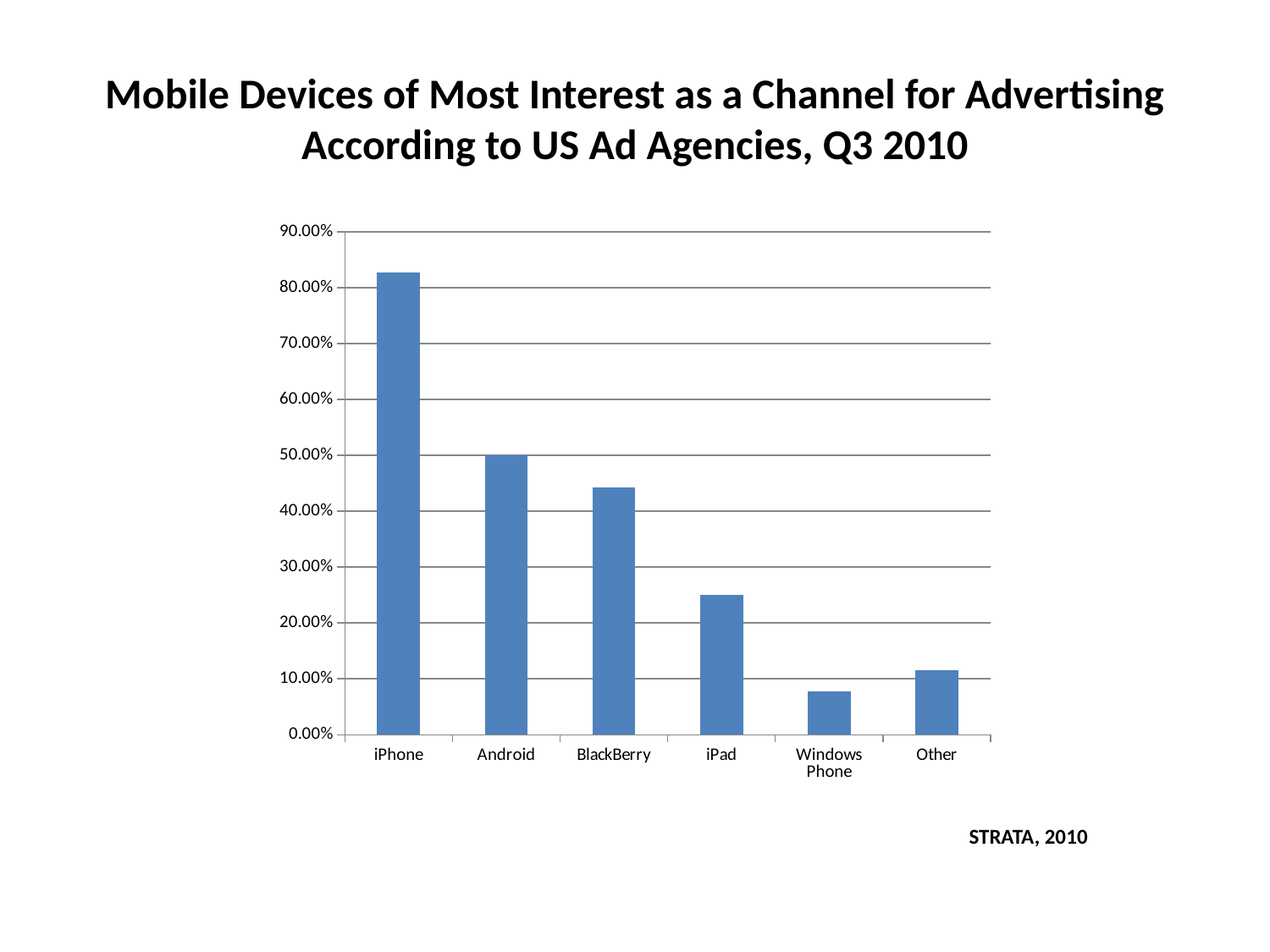
What source is cited below the chart? STRATA, 2010 Which device has the highest value? iPhone Is the value for BlackBerry greater or less than 40.00%? greater Is the value for Other greater or less than 20.00%? less Is the value for iPad greater or less than 30.00%? less What kind of chart is shown on the slide? bar chart How many device categories are shown on the x axis? 6 Which device has the lowest value? Windows Phone Which is larger, the value for Android or the value for BlackBerry? Android Which is larger, the value for iPad or the value for Other? iPad